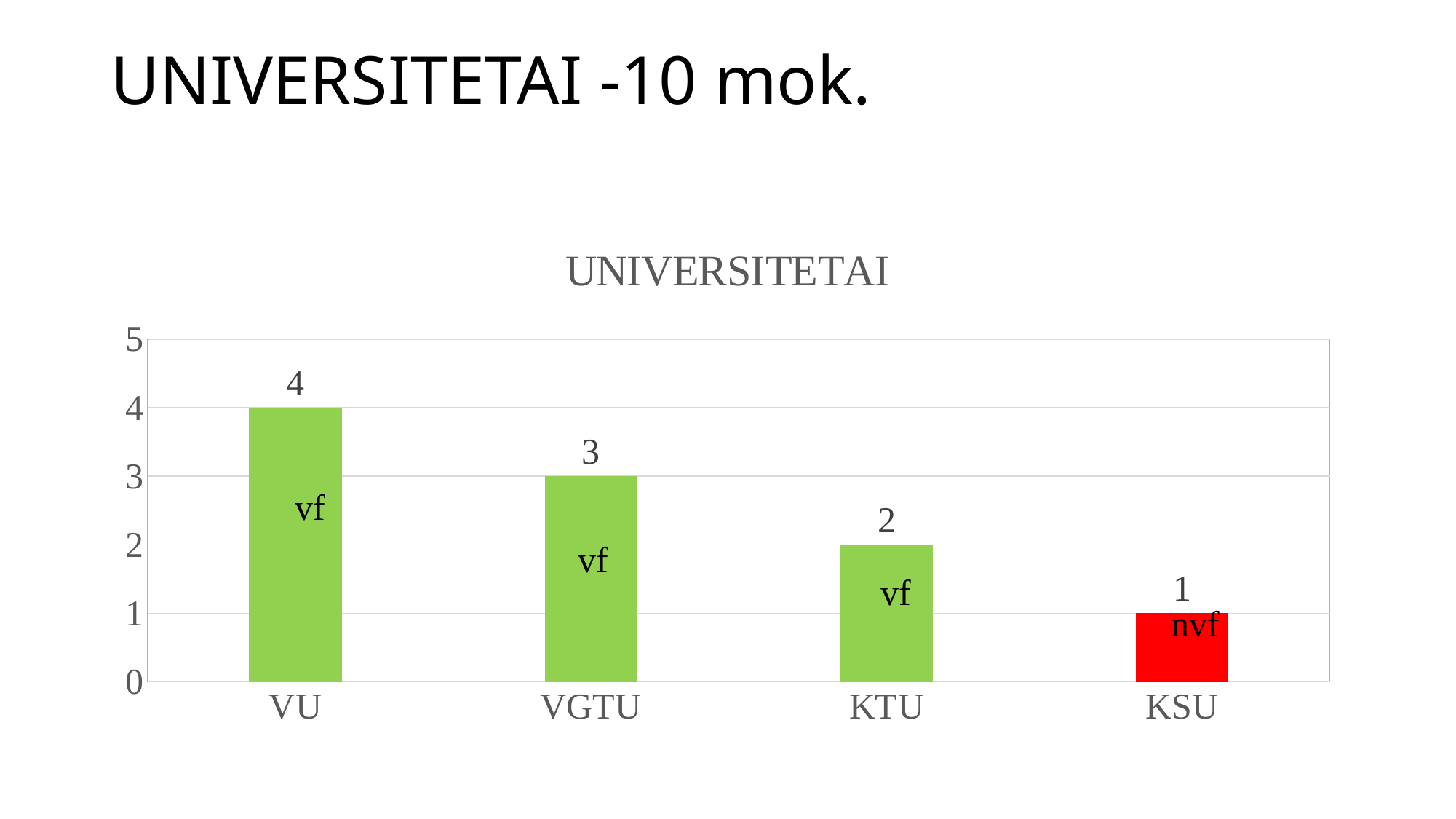
Do the values rise or fall from left to right along the x axis? fall What is the title of the chart? UNIVERSITETAI Which category has the lowest value? KSU Which category has the highest value? VU What kind of chart is this? bar chart How many categories are shown on the x axis? 4 What is the value for VU? 4 Which is larger, the value for VGTU or the value for KTU? VGTU What is the value for KTU? 2 What is the difference between the values for VU and KSU? 3 What is the value for VGTU? 3 What is the value for KSU? 1